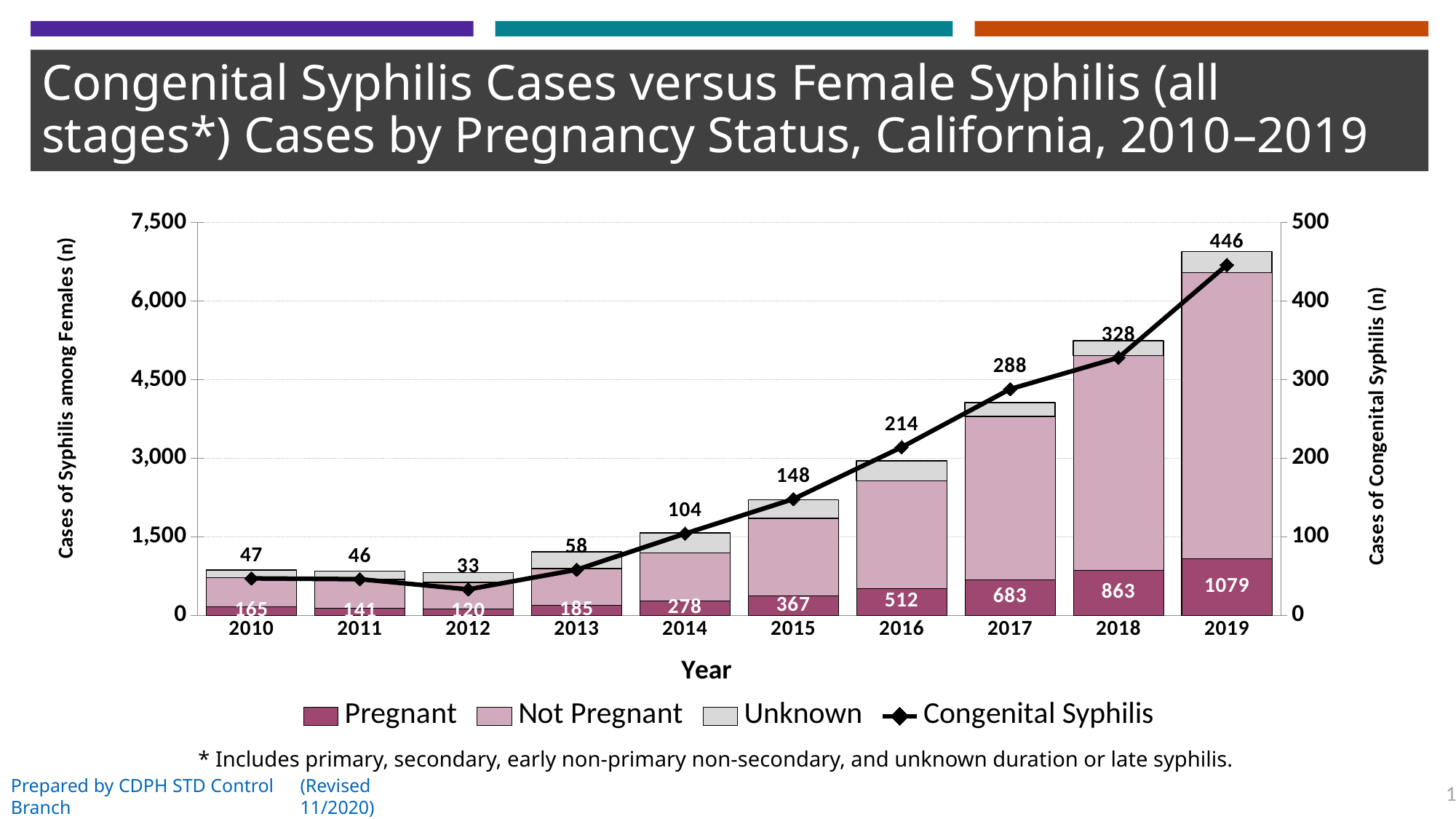
What is the value for the Pregnant series in 2017? 683 Which is larger, the congenital syphilis cases in 2010 or in 2011? 2010 What is the number of congenital syphilis cases in 2012? 33 How many years are shown on the x axis? 10 What is the overall trend of congenital syphilis cases from 2013 to 2019? rising What is the difference in congenital syphilis cases between 2019 and 2018? 118 Is the total height of the stacked bar for 2019 greater or less than 6,000? greater Which year has the highest value for the Pregnant series? 2019 Which year has the lowest number of congenital syphilis cases? 2012 How many series does the legend list? 4 What is the difference between the Pregnant values for 2019 and 2010? 914 What is the number of congenital syphilis cases in 2019? 446